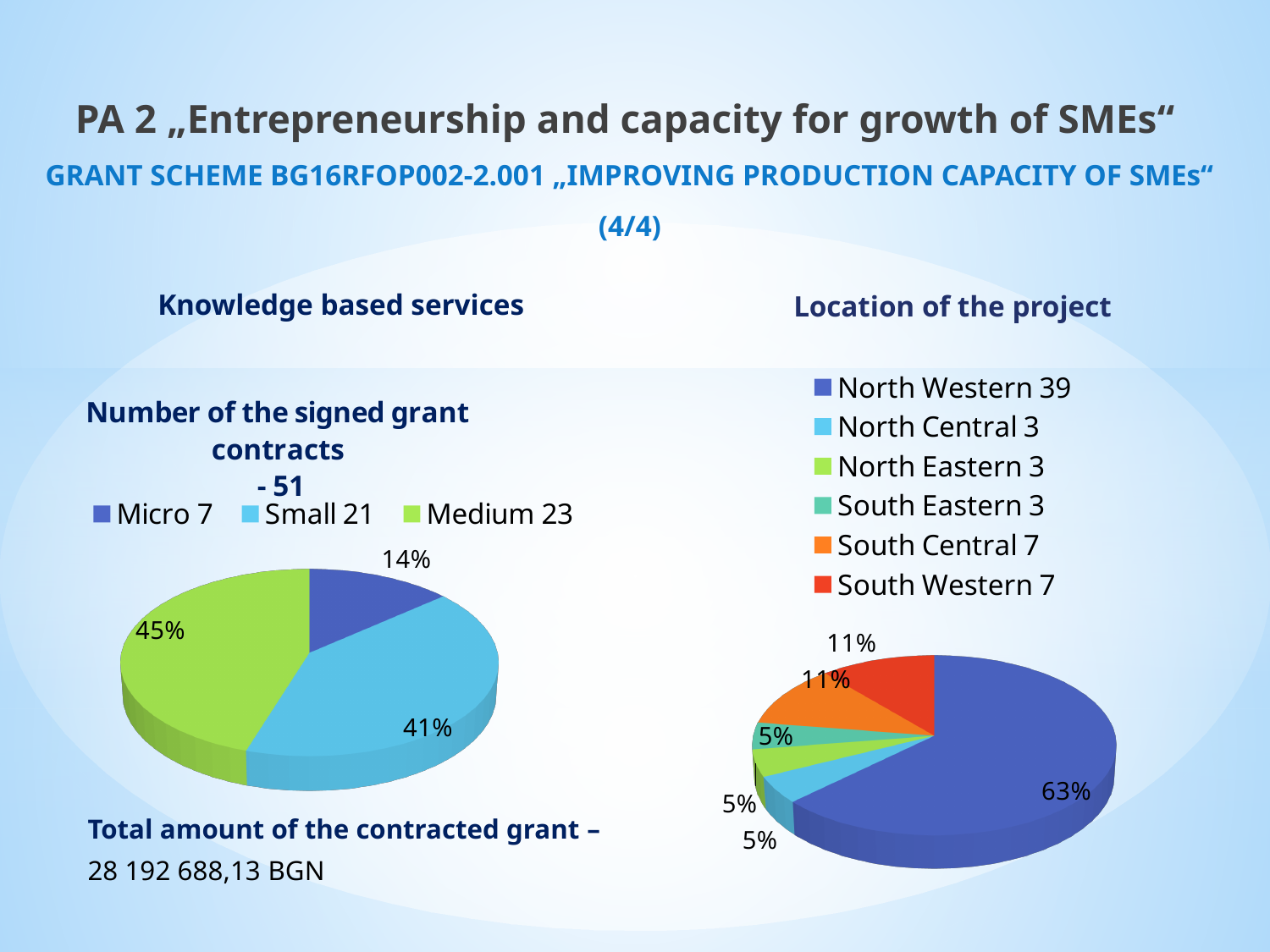
In the 'Location of the project' chart, how many projects does the legend give for South Central? 7 In the 'Number of the signed grant contracts' chart, which category has the smallest slice? Micro What kind of chart is the 'Location of the project' chart? Pie chart In the 'Location of the project' chart, how many regions does the legend list? 6 In the 'Location of the project' chart, what is the difference between the number of projects for North Western and South Western? 32 In the 'Location of the project' chart, which region has the largest slice? North Western In the 'Number of the signed grant contracts' chart, how many categories does the legend list? 3 In the 'Location of the project' chart, what share of the pie is North Western? 63% In the 'Number of the signed grant contracts' chart, what share of the pie is Micro? 14% In the 'Number of the signed grant contracts' chart, which category has the largest slice? Medium In the 'Number of the signed grant contracts' chart, how many contracts does the legend give for Small? 21 In the 'Number of the signed grant contracts' chart, what share of the pie is Medium? 45%